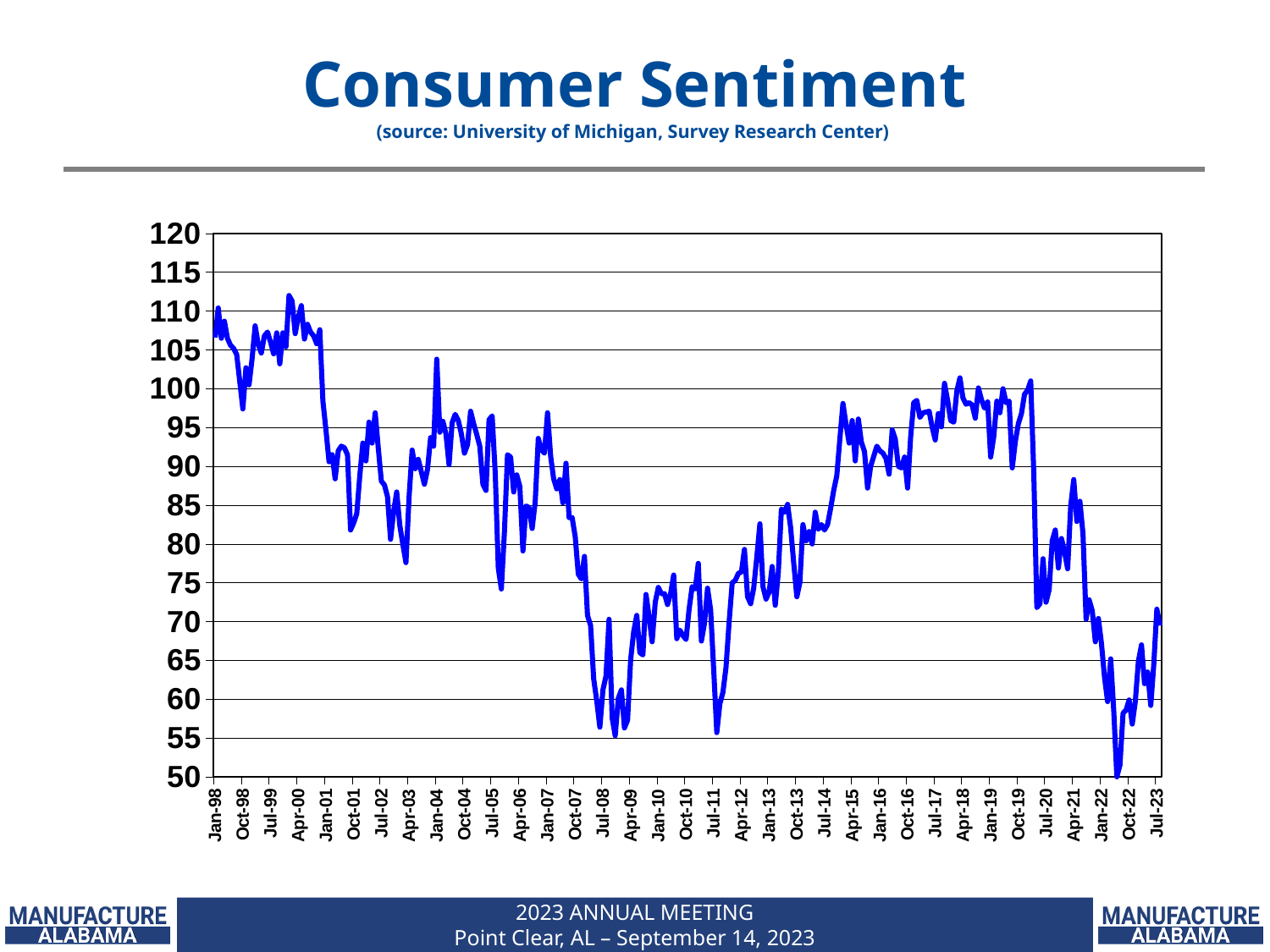
Is the consumer sentiment value at Jan-98 greater or less than 100? greater Which is higher, the consumer sentiment value at Jan-98 or at Jul-23? Jan-98 Does consumer sentiment generally rise or fall between Jul-11 and Apr-18? rise Which is higher, the consumer sentiment value at Apr-15 or at Jul-08? Apr-15 What kind of chart is shown on the slide? line chart What is the title of the chart on the slide? Consumer Sentiment Is the consumer sentiment value at Jul-08 greater or less than 70? less Is the consumer sentiment value at Apr-18 greater or less than 90? greater In which year does the consumer sentiment line reach its lowest point? 2022 What source is cited for the Consumer Sentiment chart? University of Michigan, Survey Research Center